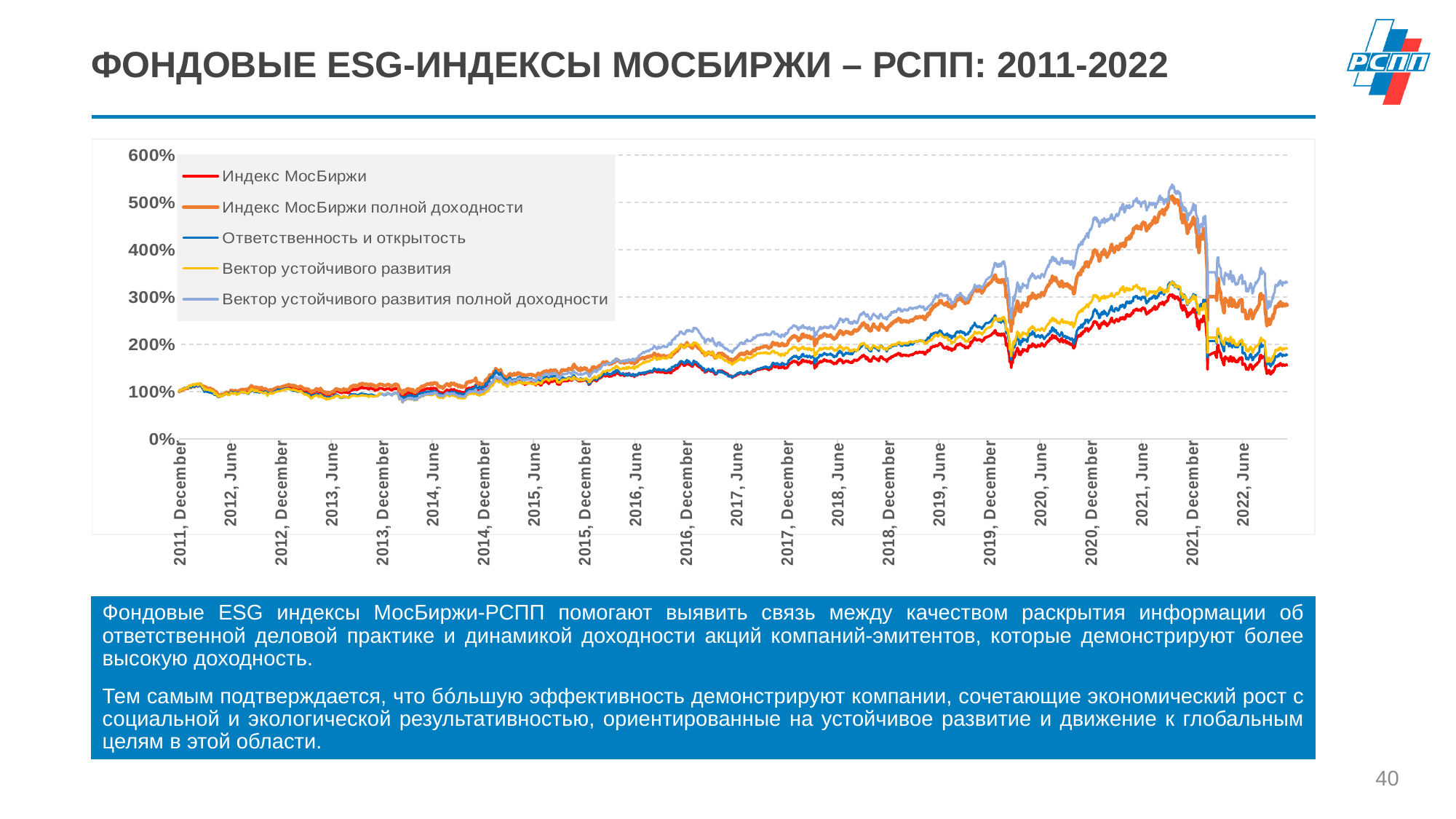
Is the peak value of Вектор устойчивого развития полной доходности around 2021, June greater or less than 500%? greater Is the value of Индекс МосБиржи at the end of the chart in 2022 greater or less than 200%? less At what value do all the series start in 2011, December? 100% Which series has the lowest value at the right end of the chart (2022)? Индекс МосБиржи Which series reaches the highest value on the chart, around 2021, June? Вектор устойчивого развития полной доходности Is the value of Индекс МосБиржи полной доходности around 2021, June greater or less than 400%? greater How many series does the legend list? 5 Around 2021, June, which is larger: Индекс МосБиржи полной доходности or Индекс МосБиржи? Индекс МосБиржи полной доходности Do the index values generally rise or fall from 2011, December to 2021, June? rise Which series is drawn in orange? Индекс МосБиржи полной доходности What kind of chart is shown on the slide? line chart Which series is drawn in red? Индекс МосБиржи